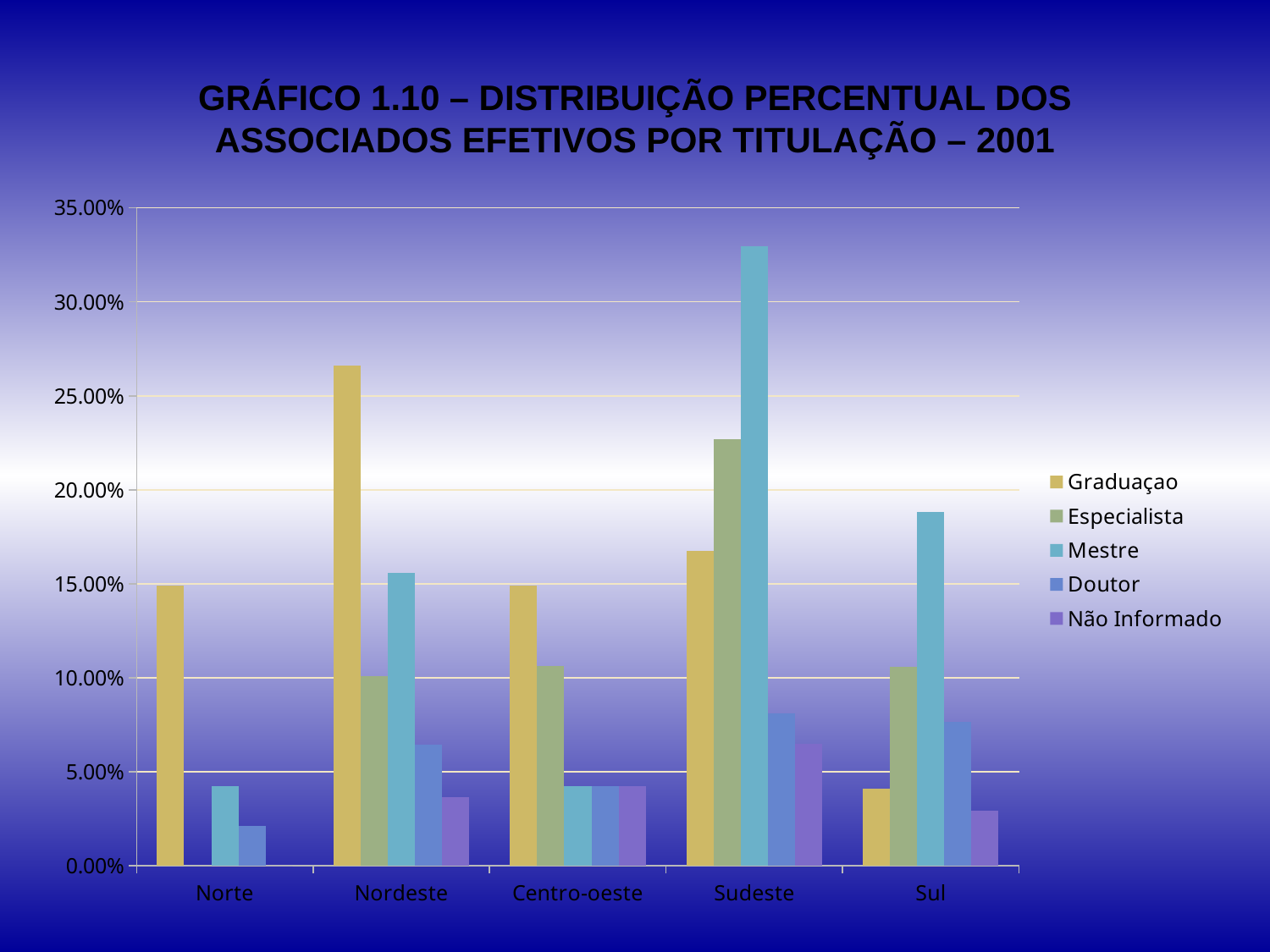
Is the Doutor value for Norte greater or less than 5.00%? less Which is larger: the Mestre value for Sudeste or the Graduaçao value for Nordeste? Mestre value for Sudeste Which region has the highest Mestre value? Sudeste Which region has the lowest Graduaçao value? Sul Which series is listed last in the legend? Não Informado How many regions are shown on the x axis? 5 Is the Mestre value for Sul greater or less than 20.00%? less What kind of chart is shown on the slide? bar chart Is the Graduaçao value for Nordeste greater or less than 25.00%? greater Which region has the highest Graduaçao value? Nordeste How many series does the legend list? 5